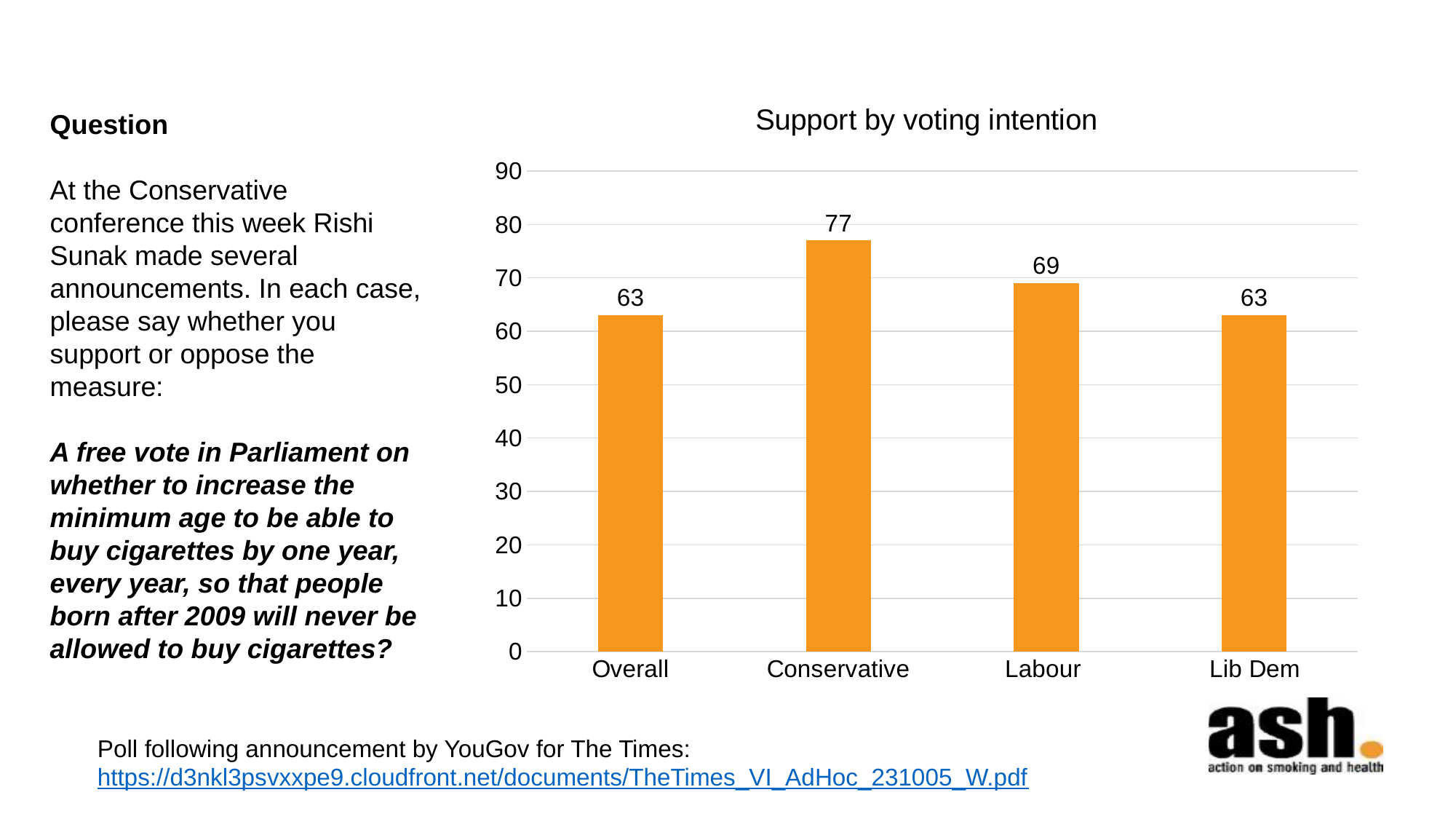
Is the value for Lib Dem greater or less than 70? less What is the difference between the Conservative and Overall values? 14 How many categories are shown on the x axis? 4 What is the value for Labour in the chart? 69 What kind of chart is shown on the slide? Bar chart What is the difference between the Conservative and Labour values? 8 Which is larger, the value for Labour or the value for Lib Dem? Labour What is the value for Overall in the chart? 63 Which category has the highest value? Conservative Is the value for Conservative greater or less than 70? greater What is the value for Conservative in the chart? 77 What is the title of the chart? Support by voting intention